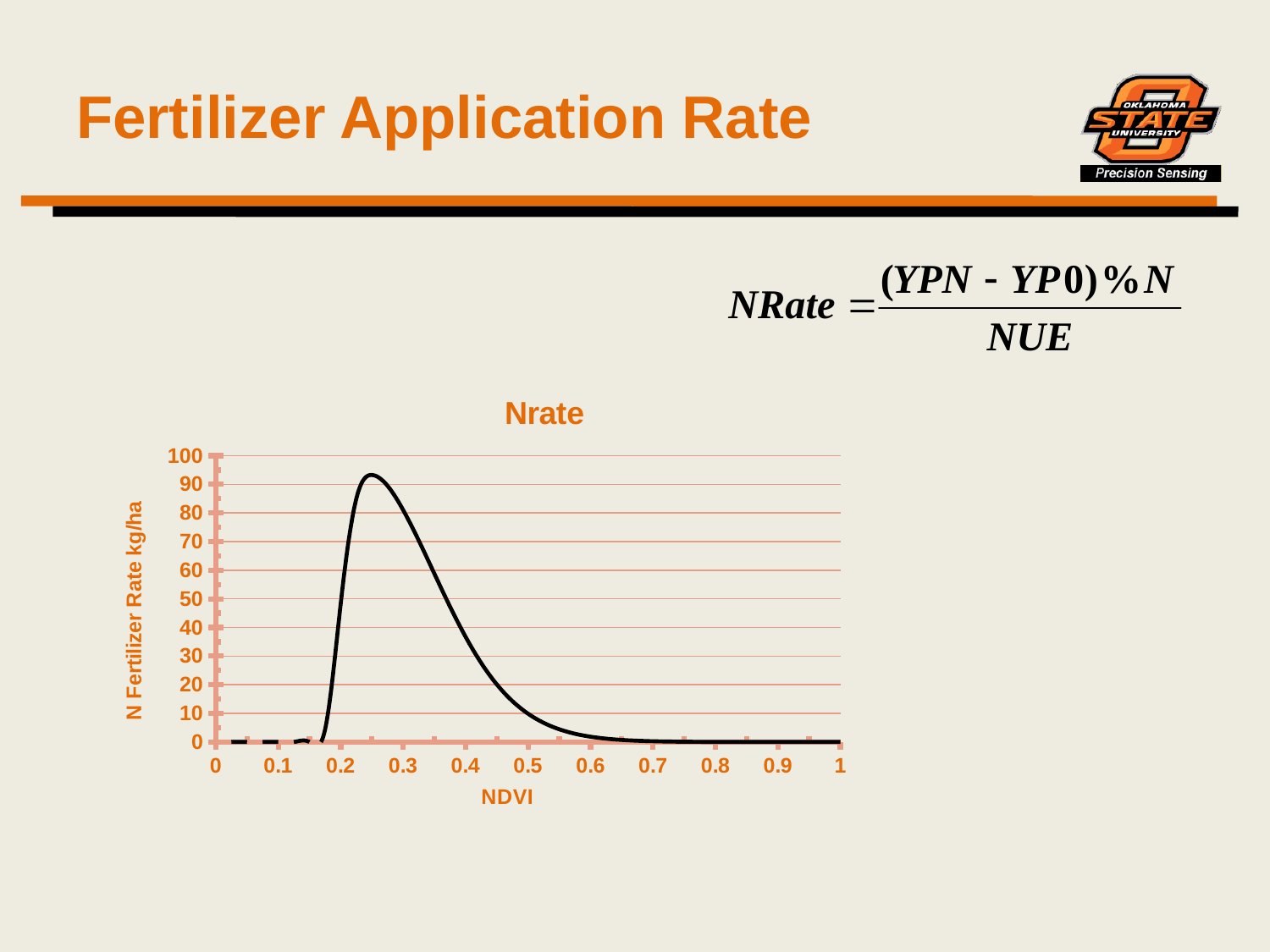
What is the title of the chart? Nrate Is the value for NDVI 0.1 greater or less than 10? less Is the value for NDVI 0.6 greater or less than 10? less Is the peak value of the curve greater or less than 80? greater Which has the larger value, NDVI 0.4 or NDVI 0.7? NDVI 0.4 Which has the larger value, NDVI 0.3 or NDVI 0.5? NDVI 0.3 What kind of chart is shown on the slide? line chart Do the values rise or fall as NDVI increases from 0.3 to 0.6? fall What is the label of the y axis of the chart? N Fertilizer Rate kg/ha